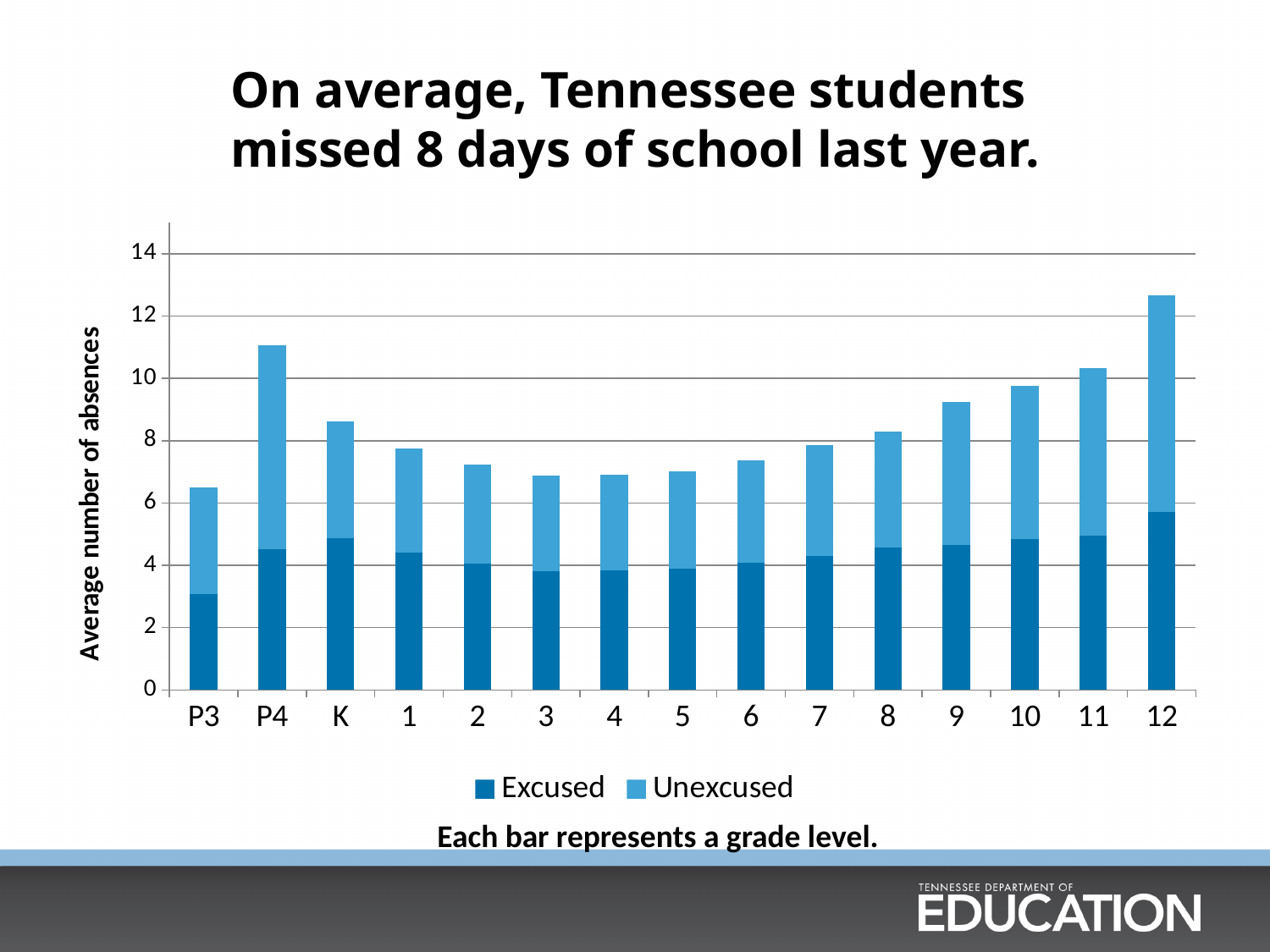
What kind of chart is shown on the slide? Stacked bar chart How many grade-level bars are plotted in the chart? 15 Which grade level has the highest total average number of absences? 12 Which has a larger total average number of absences, P3 or K? K Is the total average number of absences for P3 greater or less than 8? less Which grade level has the lowest total average number of absences? P3 Is the total average number of absences for grade 12 greater or less than 12? greater Is the total average number of absences for P4 greater or less than 10? greater Which has a larger total average number of absences, grade 12 or P4? 12 From grade 3 through grade 12, do the total average absences rise or fall? rise How many series does the legend list? 2